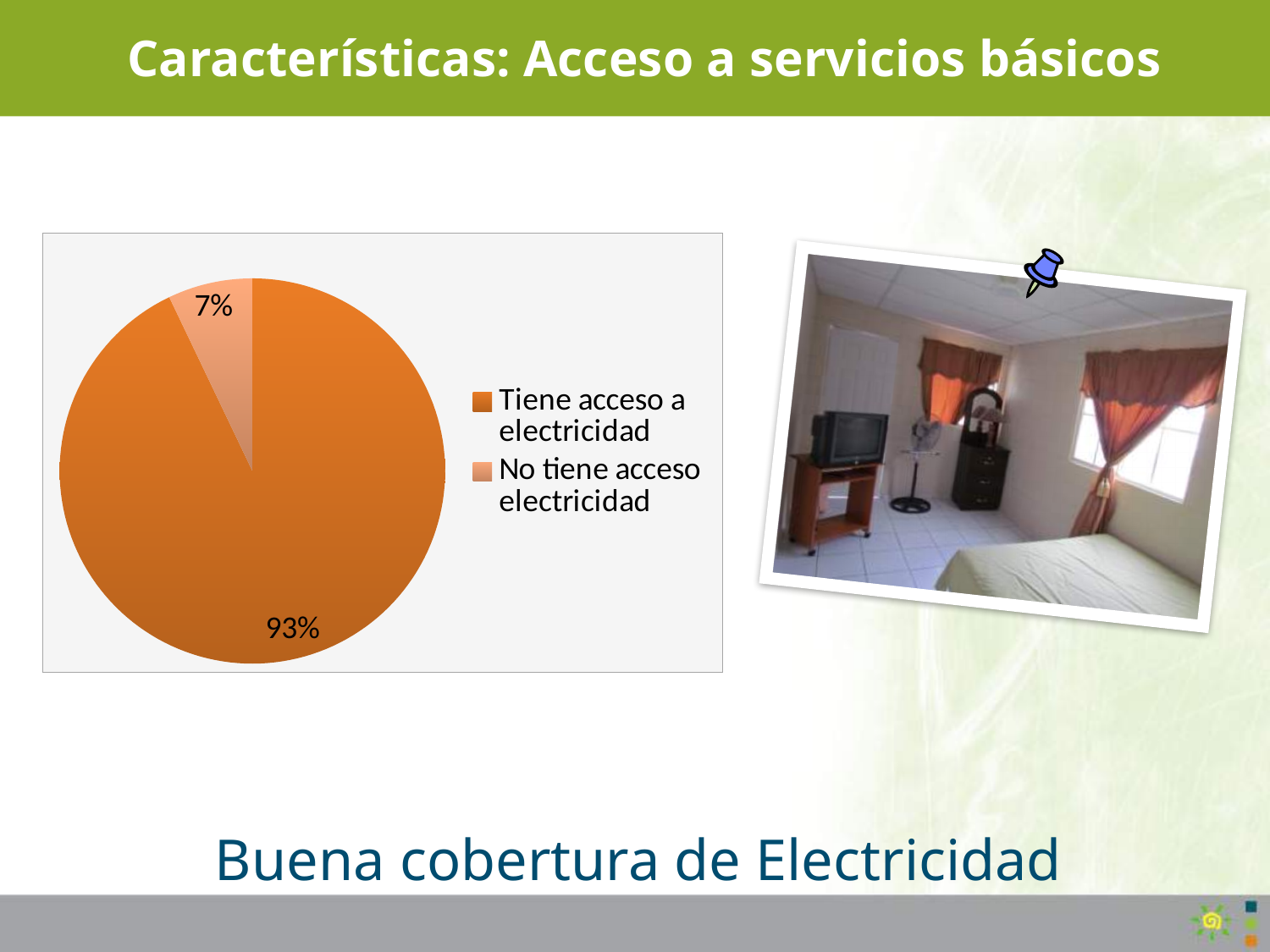
What is the value printed on the larger slice of the pie? 93% What is the value printed on the smaller slice of the pie? 7% What share of the pie does "No tiene acceso electricidad" represent? 7% Which category has the smallest slice of the pie? No tiene acceso electricidad What is the difference in percentage points between the "Tiene acceso a electricidad" slice and the "No tiene acceso electricidad" slice? 86 How many entries does the legend list? 2 How many slices does the pie chart have? 2 What is the title of the slide containing the pie chart? Características: Acceso a servicios básicos Which category has the largest slice of the pie? Tiene acceso a electricidad What kind of chart is shown on the slide? pie chart Which is larger: the slice for "Tiene acceso a electricidad" or the slice for "No tiene acceso electricidad"? Tiene acceso a electricidad What share of the pie does "Tiene acceso a electricidad" represent? 93%